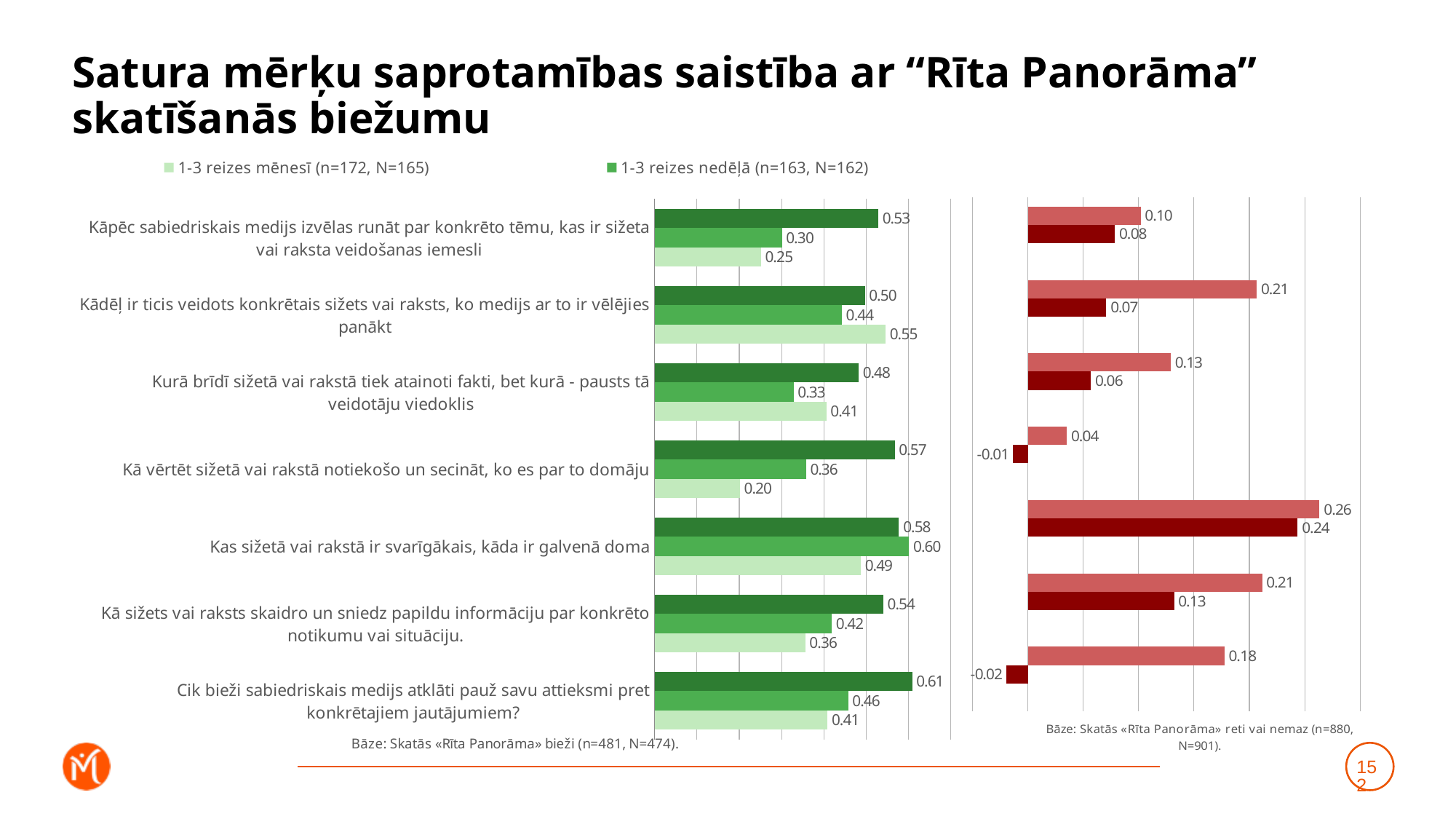
In the left (green) chart, what is the difference between the "1-3 reizes mēnesī" value and the "1-3 reizes nedēļā" value for "Kādēļ ir ticis veidots konkrētais sižets vai raksts, ko medijs ar to ir vēlējies panākt"? 0.11 In the left (green) chart, which category has the highest value for the "1-3 reizes mēnesī (n=172, N=165)" series? Kādēļ ir ticis veidots konkrētais sižets vai raksts, ko medijs ar to ir vēlējies panākt In the left (green) chart, for "Kurā brīdī sižetā vai rakstā tiek atainoti fakti, bet kurā - pausts tā veidotāju viedoklis", which series has the larger value: "1-3 reizes mēnesī" or "1-3 reizes nedēļā"? 1-3 reizes mēnesī In the left (green) chart, what is the value of the "1-3 reizes nedēļā (n=163, N=162)" series for "Kā vērtēt sižetā vai rakstā notiekošo un secināt, ko es par to domāju"? 0.36 In the right (red) chart, what is the value of the dark red bar for "Cik bieži sabiedriskais medijs atklāti pauž savu attieksmi pret konkrētajiem jautājumiem?"? -0.02 What base note is printed below the left (green) chart? Bāze: Skatās «Rīta Panorāma» bieži (n=481, N=474). What type of chart is the left (green) chart? Bar chart In the left (green) chart, what is the value of the "1-3 reizes mēnesī (n=172, N=165)" series for "Kas sižetā vai rakstā ir svarīgākais, kāda ir galvenā doma"? 0.49 In the left (green) chart, which category has the lowest value for the "1-3 reizes mēnesī (n=172, N=165)" series? Kā vērtēt sižetā vai rakstā notiekošo un secināt, ko es par to domāju In the right (red) chart, what is the value of the lighter red bar for "Kas sižetā vai rakstā ir svarīgākais, kāda ir galvenā doma"? 0.26 How many series does the legend at the top of the slide list? 2 How many categories are shown in the left (green) chart? 7